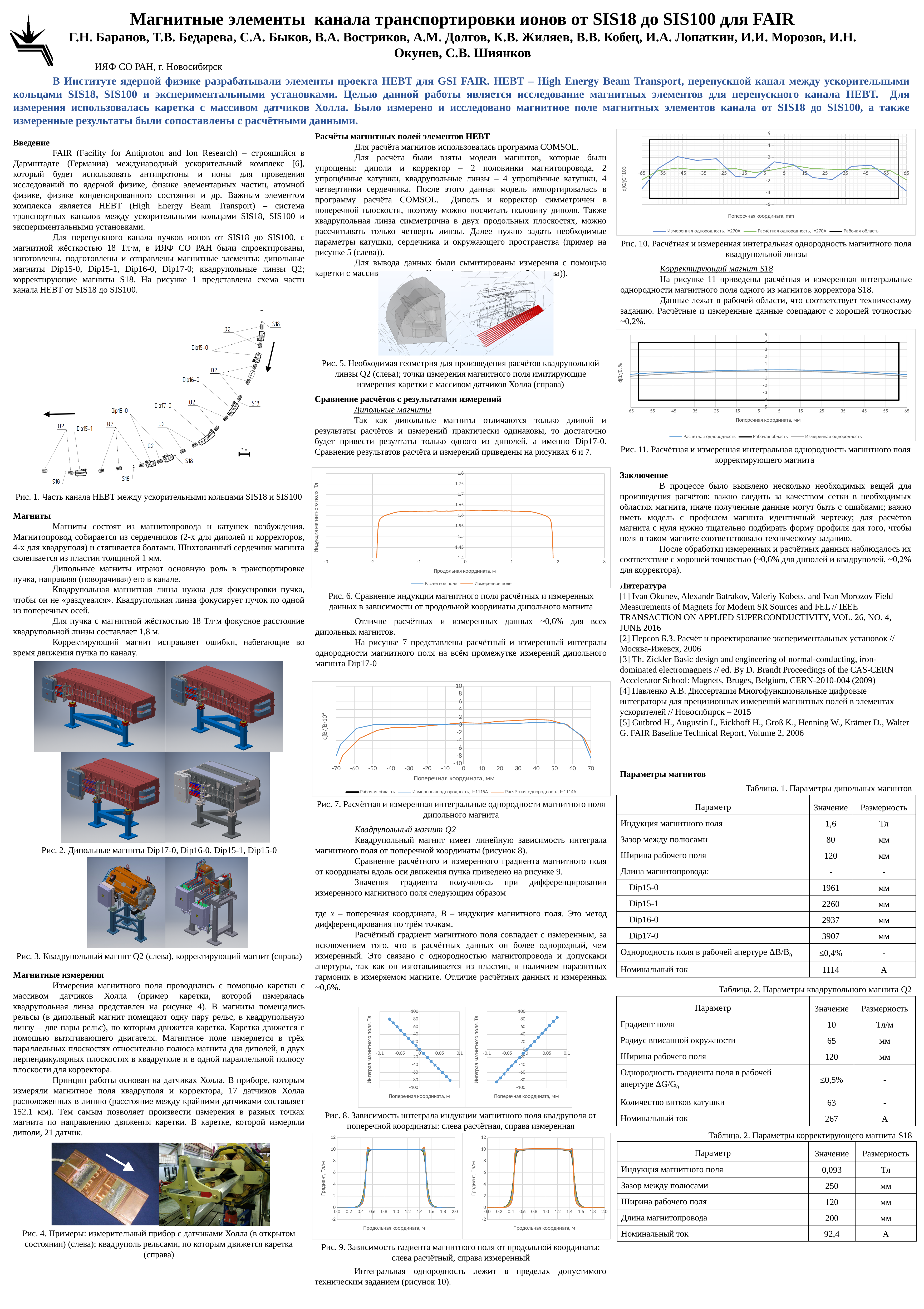
On the left chart in Fig. 9 (calculated gradient vs longitudinal coordinate), is the gradient at longitudinal coordinate 1.0 m greater or less than 8 Тл/м? greater On the chart in Fig. 10 (integral homogeneity of the quadrupole lens field), what current value is given in the legend for the measured homogeneity? I=270A On the left chart in Fig. 8 (calculated integral of the quadrupole field vs transverse coordinate), do the values rise or fall as the transverse coordinate increases? fall On the chart in Fig. 6 (induction of the dipole magnet field vs longitudinal coordinate), how many series does the legend list? 2 On the chart in Fig. 7 (integral homogeneity of the dipole magnet field), is the measured homogeneity at transverse coordinate 0 mm greater or less than 5? less On the chart in Fig. 7 (integral homogeneity of the dipole magnet field), how many series does the legend list? 3 On the right chart in Fig. 8 (measured integral of the quadrupole field vs transverse coordinate), do the values rise or fall as the transverse coordinate increases? rise On the chart in Fig. 10 (integral homogeneity of the quadrupole lens field), how many series does the legend list? 3 On the chart in Fig. 6 (induction of the dipole magnet field vs longitudinal coordinate), is the measured field at longitudinal coordinate 0 m greater or less than 1.5 Тл? greater On the chart in Fig. 6 (induction of the dipole magnet field vs longitudinal coordinate), what kind of chart is it? line chart On the chart in Fig. 6 (induction of the dipole magnet field vs longitudinal coordinate), what are the two legend entries? Расчётное поле, Измеренное поле